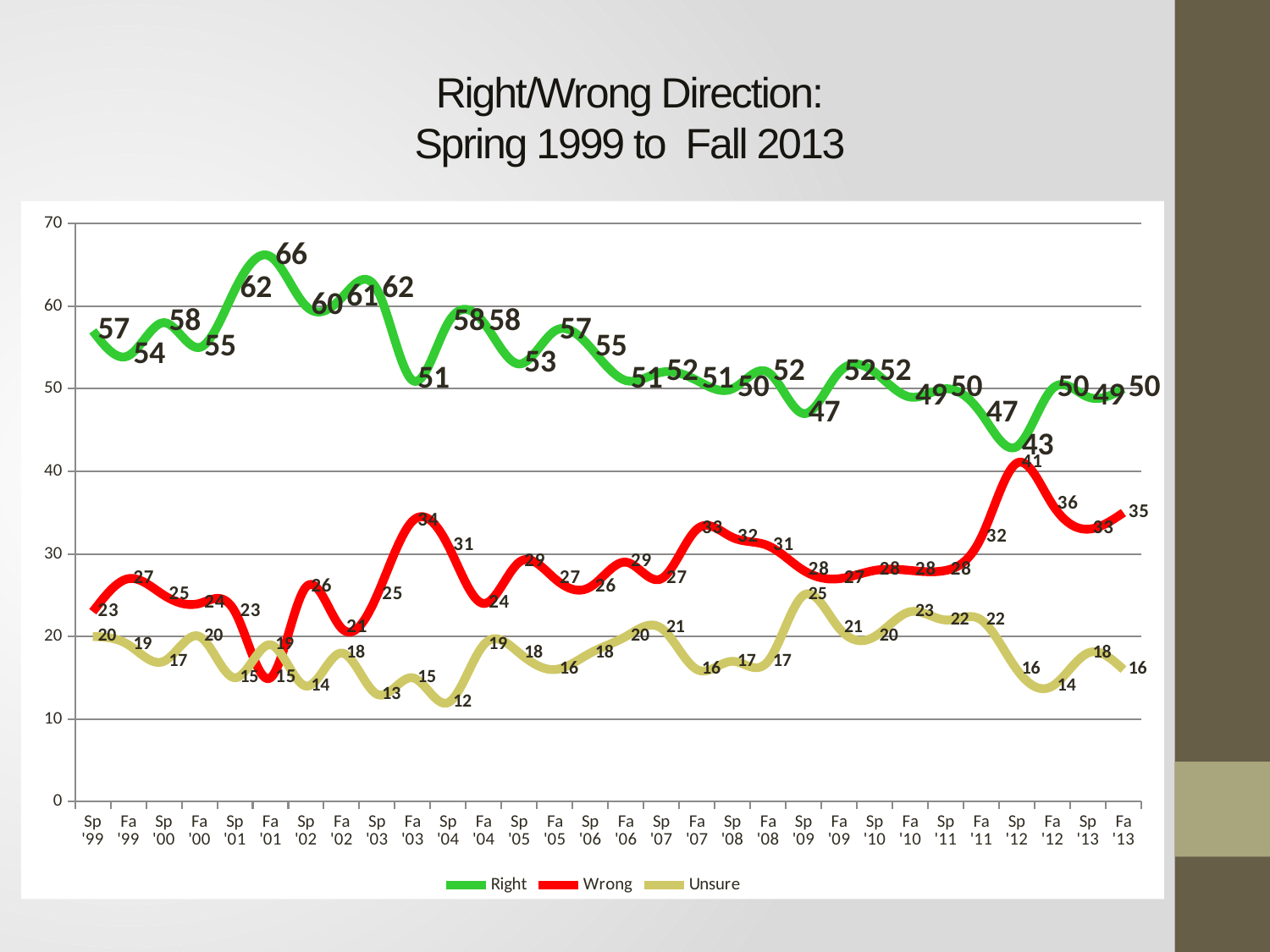
What is the title of the chart? Right/Wrong Direction: Spring 1999 to Fall 2013 At which time point does the Right series reach its highest value? Fa '01 How many series does the legend list? 3 At which time point does the Unsure series reach its lowest value? Sp '04 What type of chart is shown on the slide? Line chart At which time point does the Right series reach its lowest value? Sp '12 Which is larger at Fa '03: the Wrong value or the Unsure value? Wrong What is the value of the Right series at Fa '01? 66 What is the value of the Wrong series at Sp '12? 41 What is the value of the Unsure series at Sp '09? 25 How many time points are plotted along the x axis? 30 What is the difference between the Right and Wrong values at Fa '13? 15